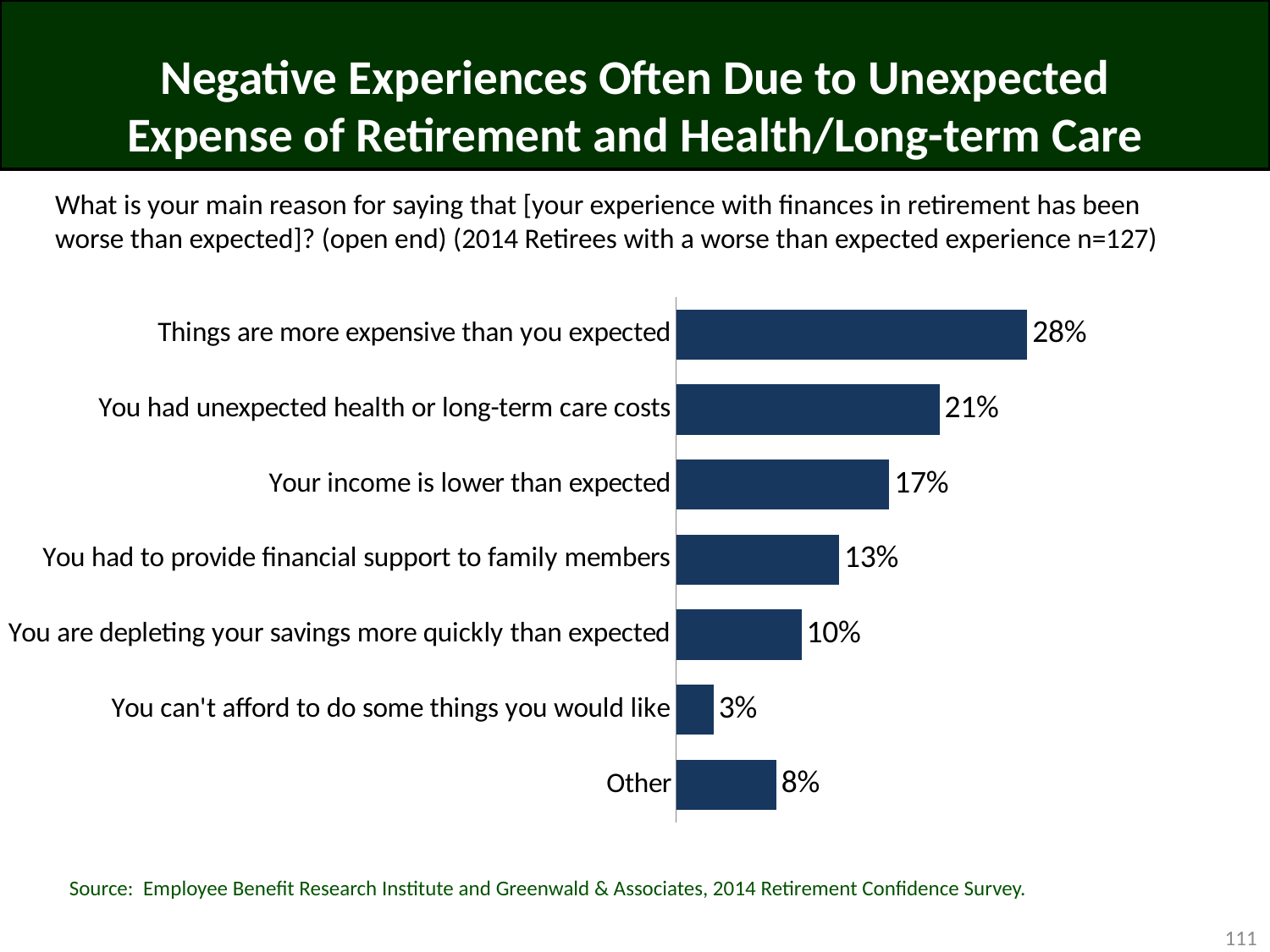
What is the difference between 'Things are more expensive than you expected' and 'You had unexpected health or long-term care costs'? 7% What is the sample size (n) stated for the 2014 retirees with a worse than expected experience? 127 What percentage said their income is lower than expected? 17% How many reasons (categories) are shown in the chart? 7 What is the value for 'You had unexpected health or long-term care costs'? 21% Which is larger: 'You had to provide financial support to family members' or 'You are depleting your savings more quickly than expected'? You had to provide financial support to family members What kind of chart is shown on the slide? Bar chart What percentage of respondents said things are more expensive than they expected? 28% What is the value for 'Other'? 8% Which reason has the lowest percentage? You can't afford to do some things you would like What is the difference between 'Other' and 'You can't afford to do some things you would like'? 5% Which reason has the highest percentage? Things are more expensive than you expected